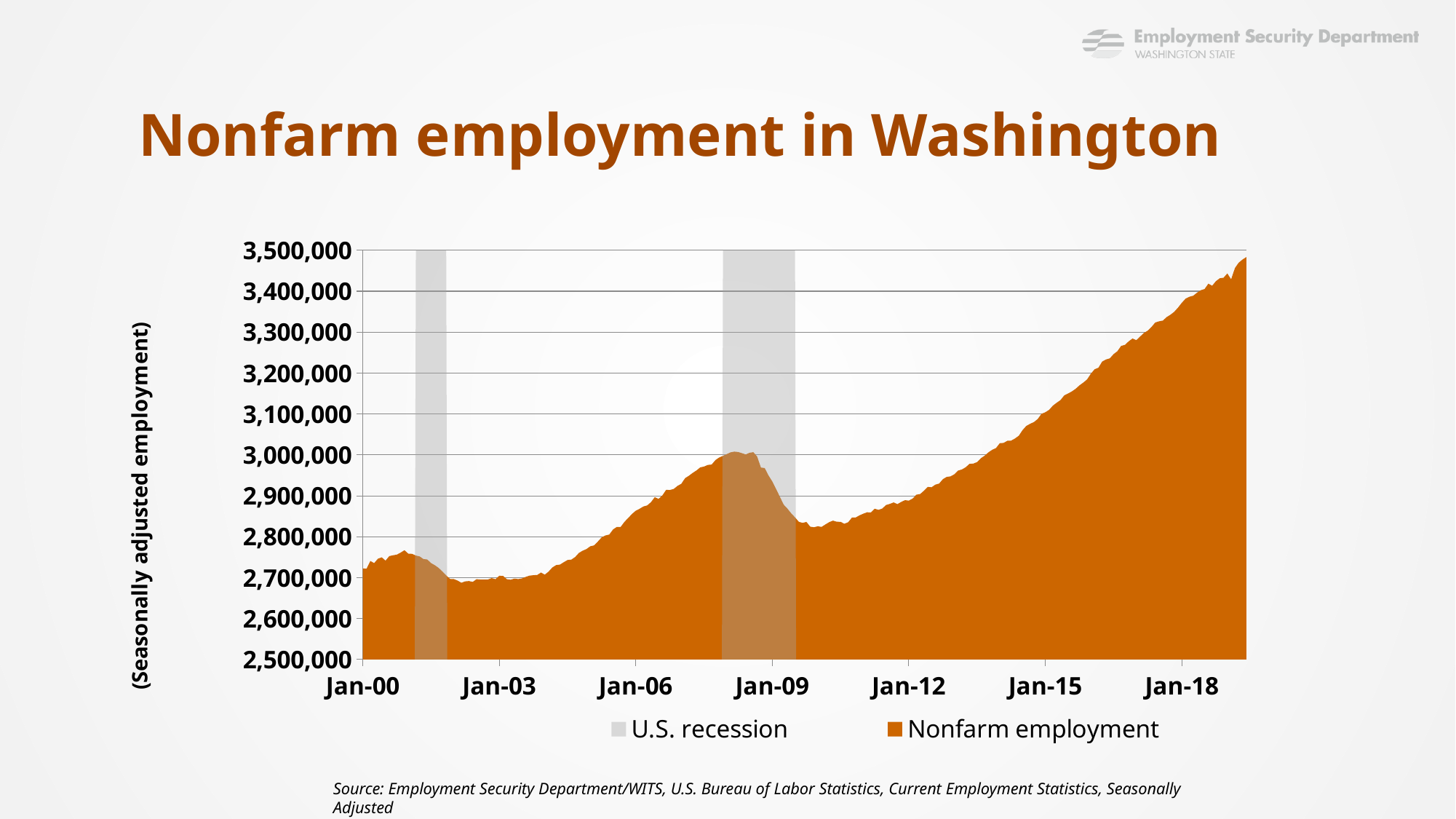
How many entries does the chart legend list? 2 What kind of chart is shown on the slide? Area chart What is the title of the chart on the slide? Nonfarm employment in Washington Is the nonfarm employment value at Jan-18 greater or less than 3,300,000? greater Does nonfarm employment rise or fall between Jan-12 and Jan-18? Rise What does the y-axis label say? (Seasonally adjusted employment) Is the nonfarm employment value at Jan-15 greater or less than 3,000,000? greater Is the nonfarm employment value at Jan-06 greater or less than 2,800,000? greater Which is larger, nonfarm employment at Jan-00 or at Jan-18? Jan-18 How many U.S. recession periods are shaded on the chart? 2